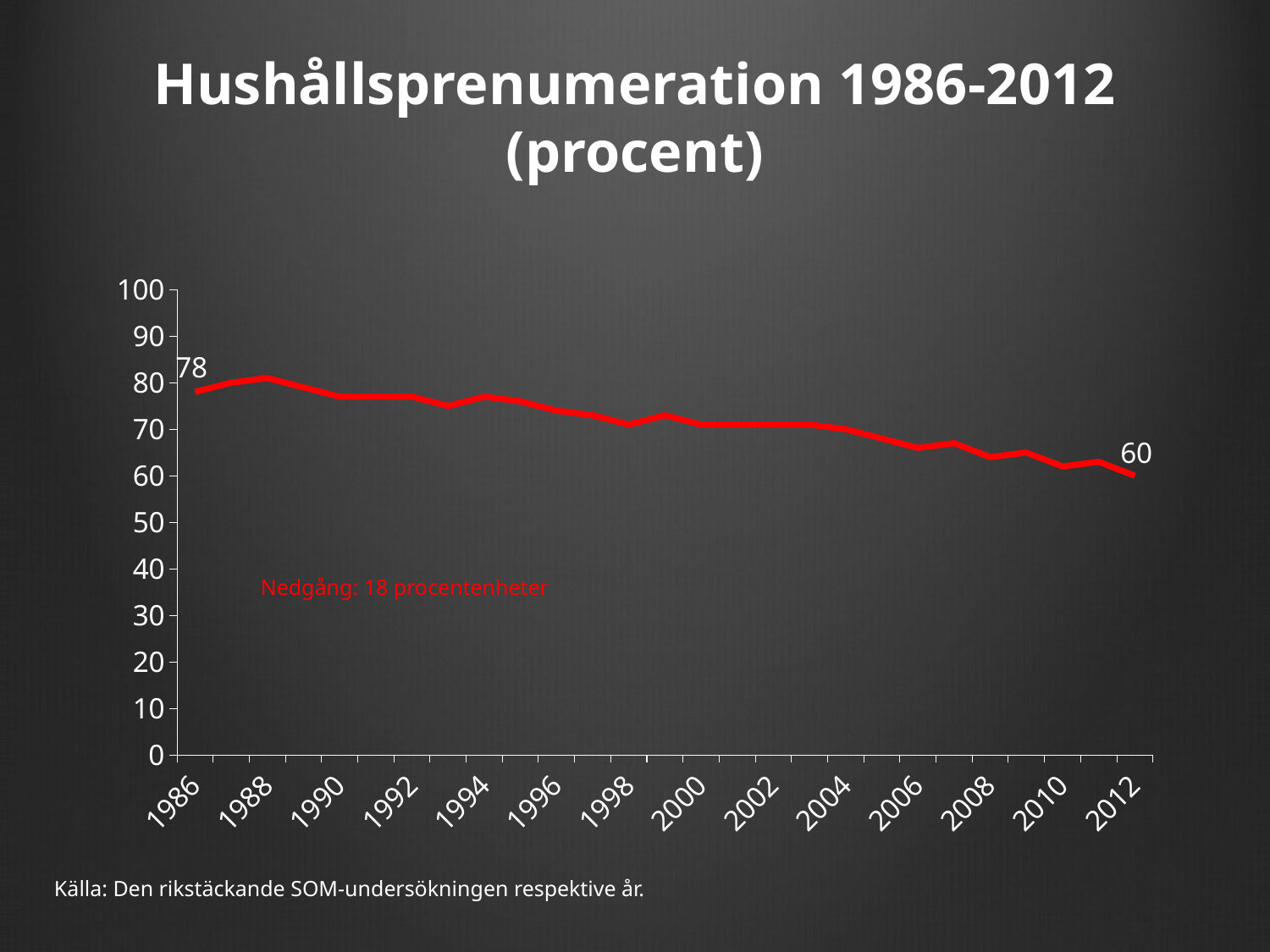
What is the title of the chart? Hushållsprenumeration 1986-2012 (procent) Do the values rise or fall from 1986 to 2012? fall Which is larger, the value for 1986 or the value for 2012? 1986 Is the value for 2006 greater or less than 70? less Is the value for 2008 greater or less than 70? less What is the difference between the value for 1986 and the value for 2012? 18 What is the value for 1986? 78 What does the red annotation text inside the chart say? Nedgång: 18 procentenheter What kind of chart is shown on the slide? line chart What is the value for 2012? 60 Is the value for 1994 greater or less than 70? greater Which year has the lowest value? 2012